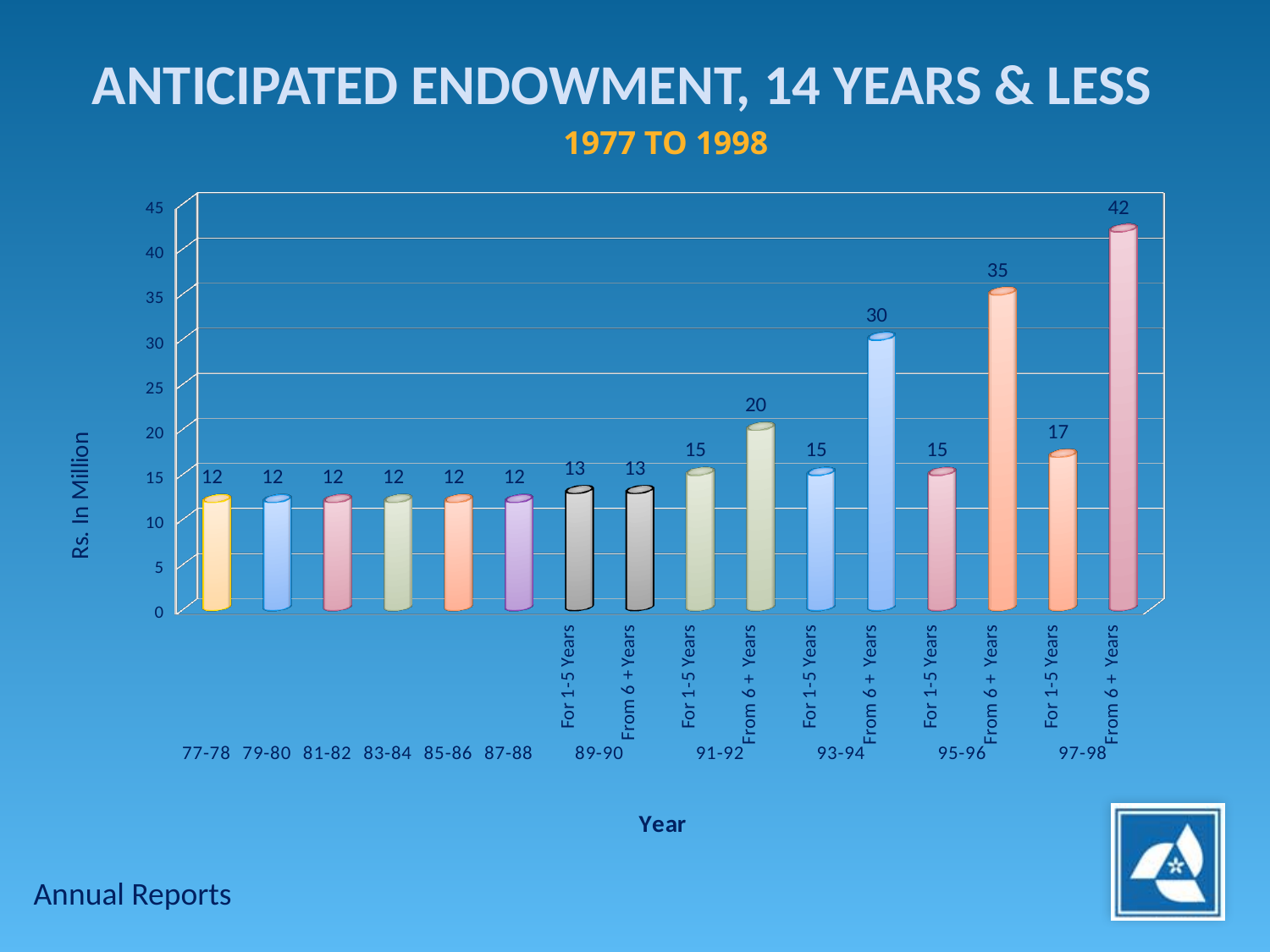
Do the 'From 6 + Years' values rise or fall from 89-90 to 97-98? Rise What is the value for 'From 6 + Years' in 97-98? 42 What is the difference between 'From 6 + Years' in 97-98 and 'From 6 + Years' in 93-94? 12 What is the difference between 'From 6 + Years' in 95-96 and 'For 1-5 Years' in 95-96? 20 What is the label of the vertical axis? Rs. In Million Which is larger: 'From 6 + Years' in 91-92 or 'For 1-5 Years' in 97-98? From 6 + Years in 91-92 What is the value for 'From 6 + Years' in 93-94? 30 What is the value for 'For 1-5 Years' in 91-92? 15 What is the value for 77-78? 12 Which bar has the highest value? From 6 + Years, 97-98 How many bars are plotted in the chart? 16 What kind of chart is shown? Bar chart